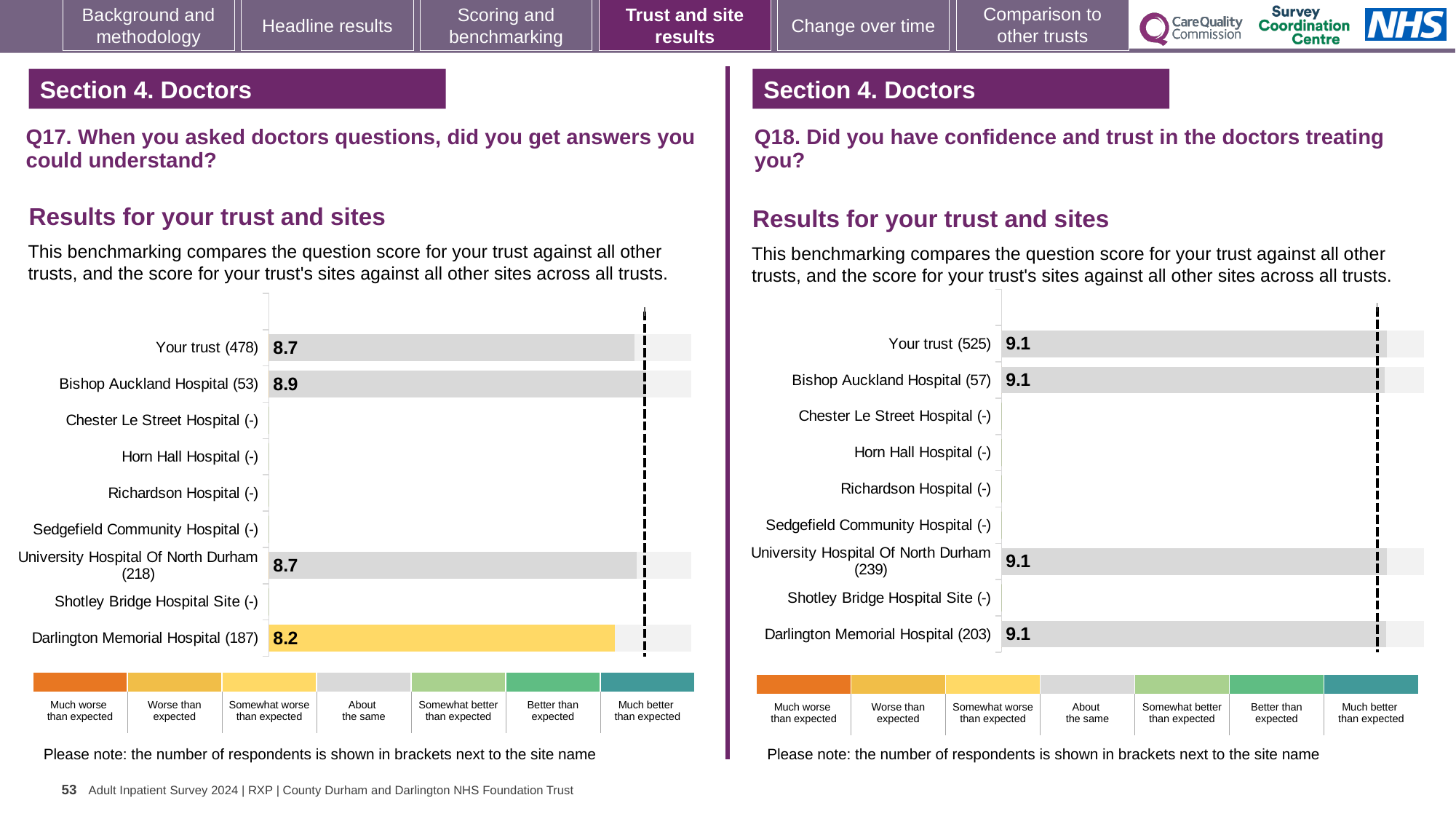
On the Q17 chart (left), which has the larger score, University Hospital Of North Durham or Darlington Memorial Hospital? University Hospital Of North Durham On the Q17 chart (left), what is the difference between the scores for Bishop Auckland Hospital and Darlington Memorial Hospital? 0.7 On the Q17 chart (left), which benchmark category does the colour of the Darlington Memorial Hospital bar correspond to? Somewhat worse than expected On the Q17 chart (left), which site has the lowest score? Darlington Memorial Hospital On the Q18 chart (right), what is the score for Darlington Memorial Hospital? 9.1 On the Q17 chart (left), what is the score for Your trust? 8.7 On the Q17 chart (left), which site has the highest score? Bishop Auckland Hospital On the Q17 chart (left), what is the score for Bishop Auckland Hospital? 8.9 On the Q18 chart (right), what is the score for Your trust? 9.1 On the Q17 chart (left), what is the score for Darlington Memorial Hospital? 8.2 On the Q18 chart (right), how many respondents are shown in brackets for University Hospital Of North Durham? 239 What kind of chart is used on the Q17 chart (left)? Bar chart